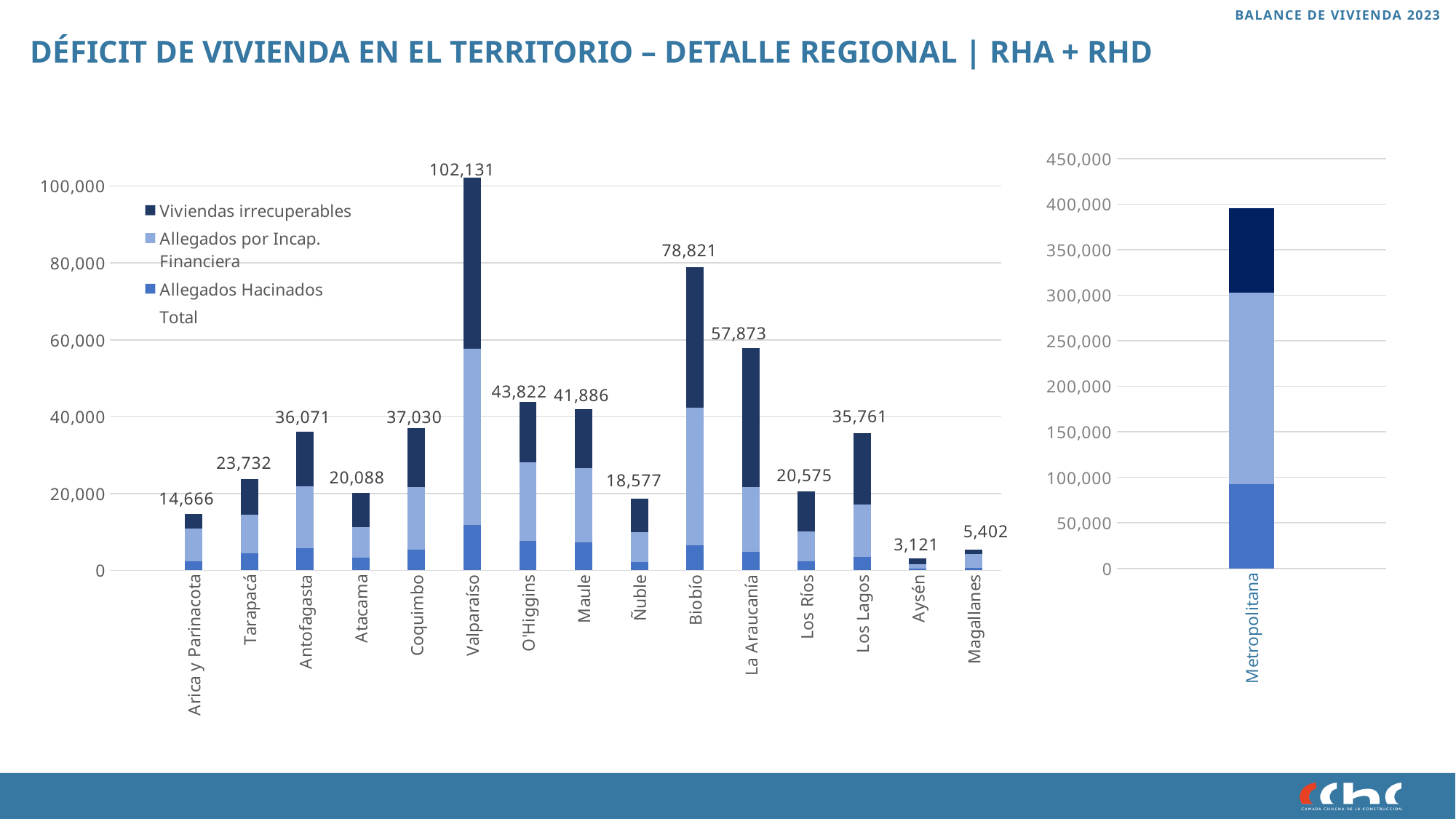
On the left chart, what is the total value labelled for Los Lagos? 35,761 On the right chart, is the total value for Metropolitana greater or less than 350,000? greater On the left chart, what is the total value labelled for Valparaíso? 102,131 On the left chart, which has a larger total, La Araucanía or O'Higgins? La Araucanía On the left chart, what is the difference between the totals for Magallanes and Aysén? 2,281 On the left chart, which region has the highest total? Valparaíso On the left chart, which region has the lowest total? Aysén On the left chart, what is the total value labelled for Biobío? 78,821 On the left chart, what is the difference between the totals for Valparaíso and Biobío? 23,310 On the left chart, how many regions are shown on the x axis? 15 On the left chart, how many entries does the legend list? 4 What kind of chart is the left chart? Stacked bar chart